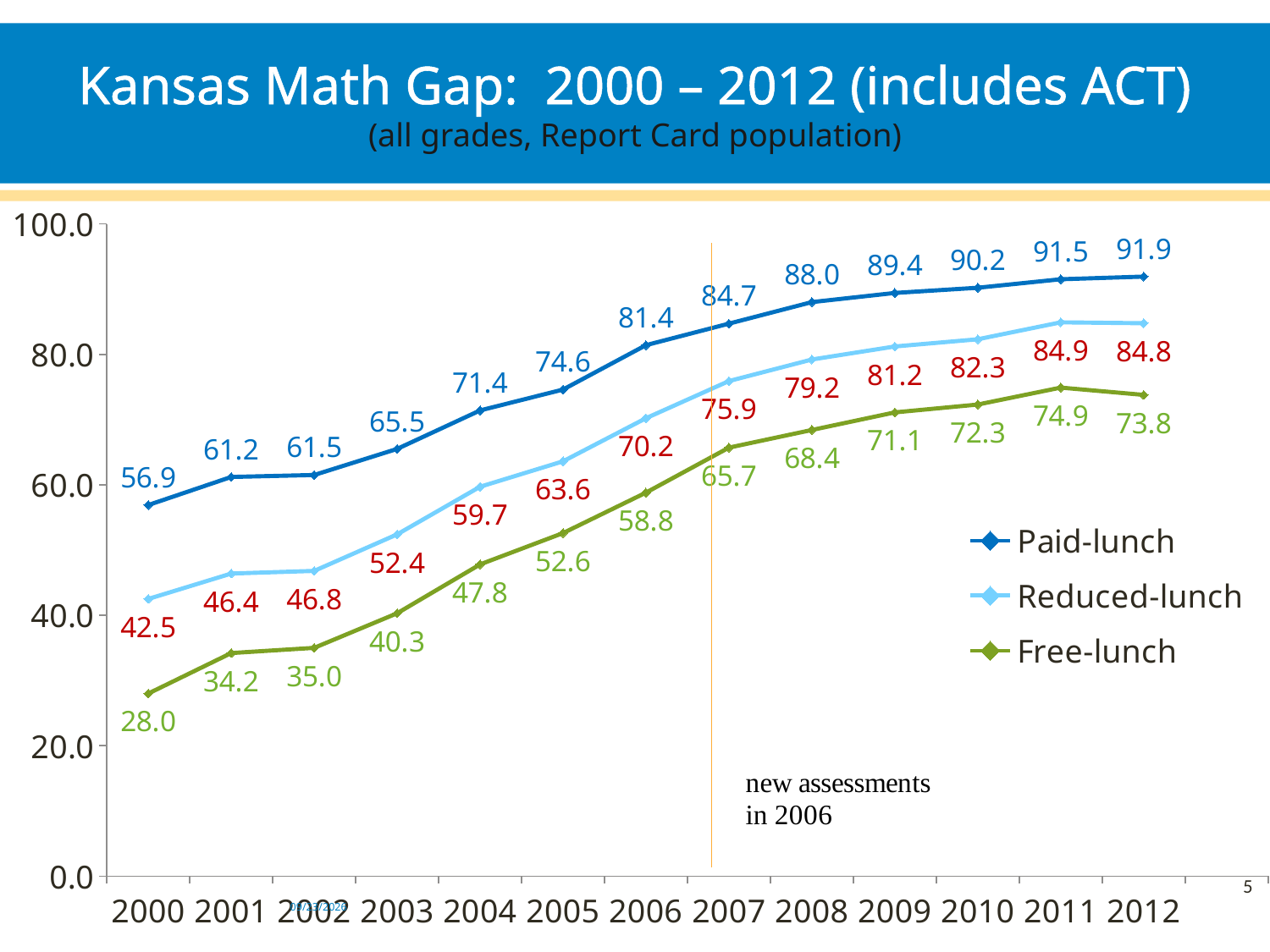
How many years are plotted on the x axis? 13 In which year is the Free-lunch value lowest? 2000 Which is larger for Reduced-lunch, the 2011 value or the 2012 value? 2011 How many series does the legend list? 3 What is the Paid-lunch value for 2000? 56.9 What is the Reduced-lunch value for 2007? 75.9 Does the Free-lunch series generally rise or fall from 2000 to 2011? Rise In which year is the Paid-lunch value highest? 2012 What is the difference between the Paid-lunch and Free-lunch values in 2012? 18.1 What is the Free-lunch value for 2012? 73.8 What is the difference between the Paid-lunch and Free-lunch values in 2000? 28.9 What kind of chart is shown on the slide? Line chart